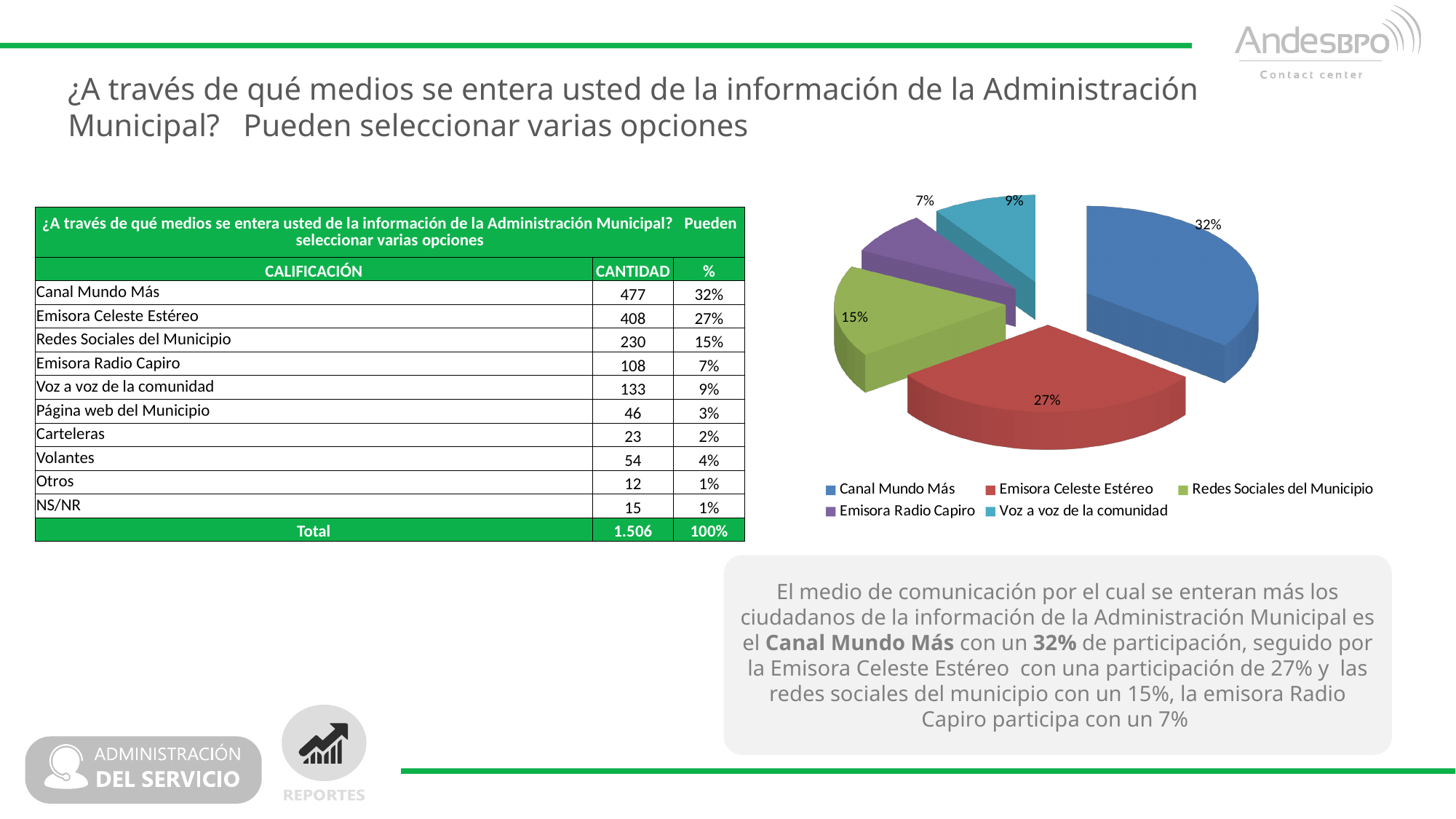
What is the difference in percentage points between Canal Mundo Más and Emisora Celeste Estéreo in the pie chart? 5 What colour is the Redes Sociales del Municipio slice in the pie chart? green What percentage does the pie chart show for Canal Mundo Más? 32% What percentage does the pie chart show for Emisora Radio Capiro? 7% What kind of chart is shown on the slide? pie chart How many slices does the pie chart have? 5 What percentage does the pie chart show for Voz a voz de la comunidad? 9% Which slice is larger in the pie chart, Voz a voz de la comunidad or Emisora Radio Capiro? Voz a voz de la comunidad Which category has the smallest slice in the pie chart? Emisora Radio Capiro What percentage does the pie chart show for Emisora Celeste Estéreo? 27% Which category has the largest slice in the pie chart? Canal Mundo Más What percentage does the pie chart show for Redes Sociales del Municipio? 15%